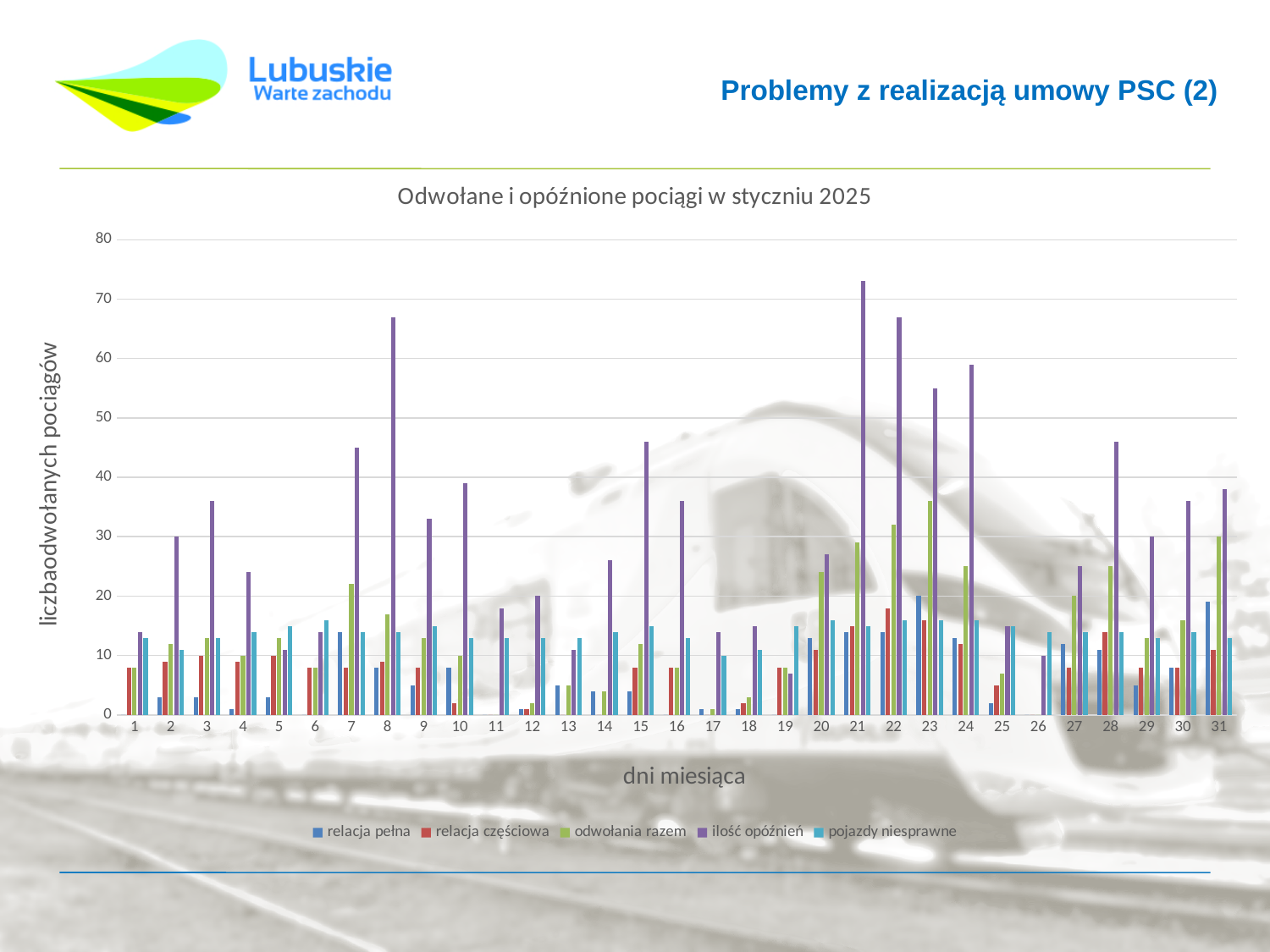
Is the value for ilość opóźnień on day 1 greater or less than 20? less Which is larger: ilość opóźnień on day 21 or on day 1? day 21 How many days (categories) are shown on the x axis? 31 On which day is the value for ilość opóźnień highest? 21 How many series does the legend list? 5 Is the value for ilość opóźnień on day 21 greater or less than 60? greater What kind of chart is shown on the slide? bar chart Is the value for odwołania razem on day 23 greater or less than 30? greater What is the label of the x axis? dni miesiąca Which is larger: odwołania razem on day 22 or on day 17? day 22 What is the title of the chart? Odwołane i opóźnione pociągi w styczniu 2025